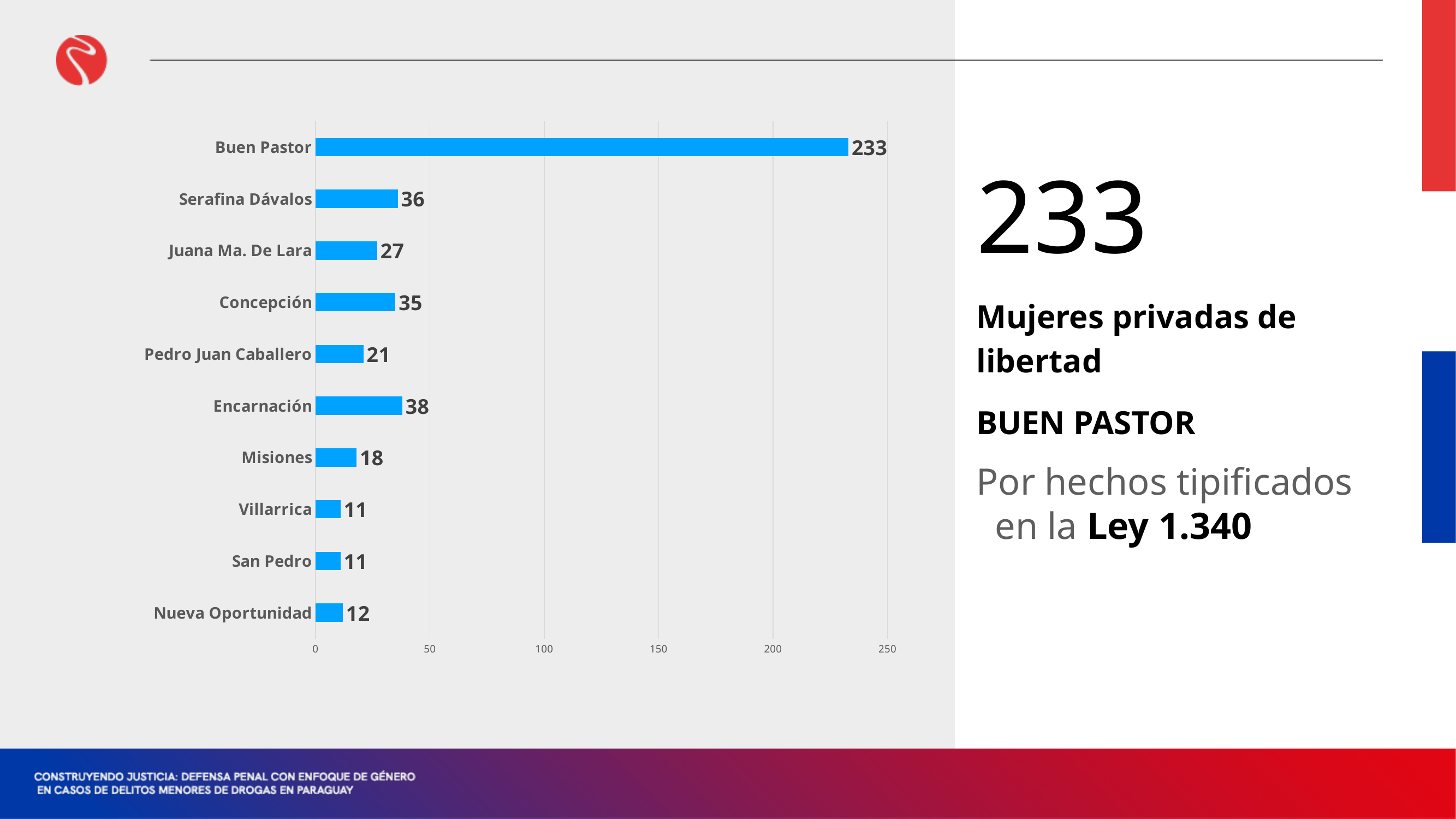
What is the value for Nueva Oportunidad? 12 Is the value for Buen Pastor greater or less than 200? greater Which is larger, the value for Concepción or the value for Misiones? Concepción What is the value for Encarnación? 38 What kind of chart is shown on the slide? bar chart What is the difference between the values for Serafina Dávalos and Juana Ma. De Lara? 9 What is the difference between the values for Buen Pastor and Encarnación? 195 How many categories are shown in the chart? 10 What is the value for Buen Pastor? 233 What is the value for Pedro Juan Caballero? 21 Which category has the highest value? Buen Pastor What colour are the bars in the chart? blue